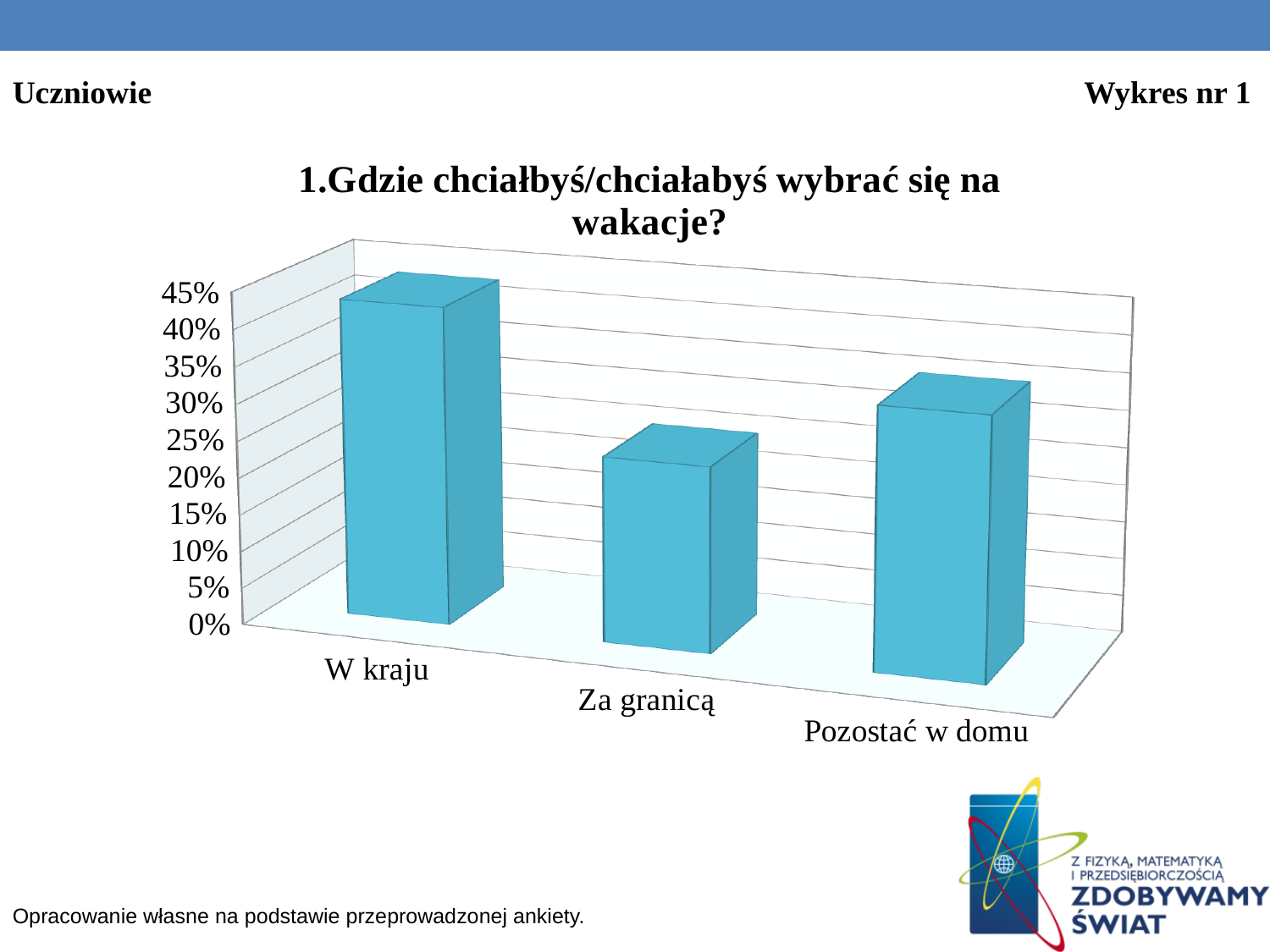
Is the value for Pozostać w domu greater or less than 40%? less What is the title of the chart? 1.Gdzie chciałbyś/chciałabyś wybrać się na wakacje? Is the value for Pozostać w domu greater or less than 20%? greater Which is larger, the value for Pozostać w domu or the value for Za granicą? Pozostać w domu Is the value for Za granicą greater or less than 15%? greater What kind of chart is shown on the slide? bar chart Which is larger, the value for W kraju or the value for Za granicą? W kraju Which category has the lowest bar? Za granicą How many categories are shown on the x axis of the chart? 3 Which category has the highest bar? W kraju